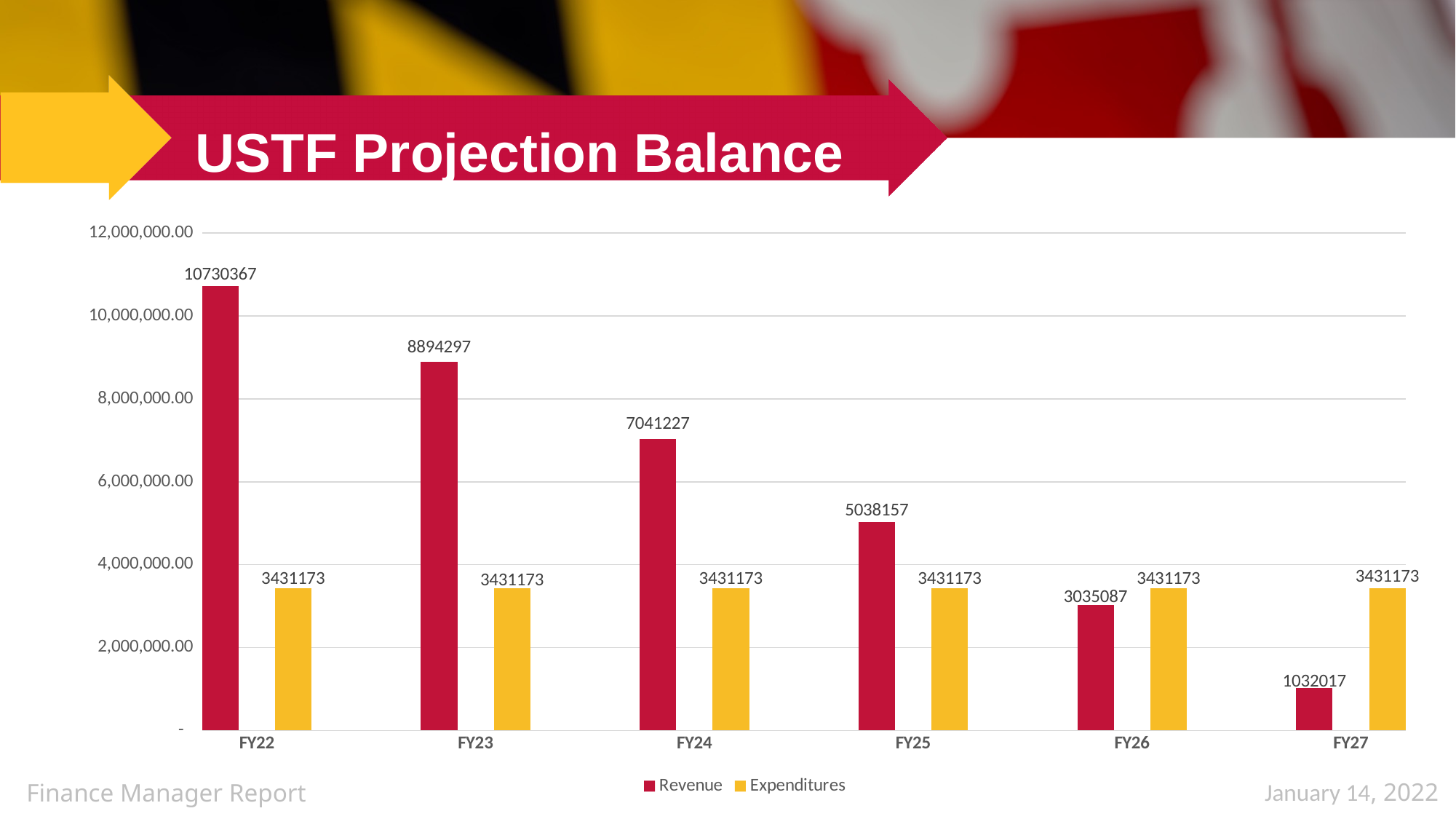
What is the difference between Revenue and Expenditures in FY24? 3610054 Which fiscal year has the highest Revenue? FY22 Which fiscal year has the lowest Revenue? FY27 Does Revenue rise or fall from FY22 to FY27? Fall What is the Expenditures value for FY25? 3431173 How many fiscal years are shown on the x axis? 6 Is the Revenue value for FY23 greater or less than 8,000,000.00? greater In FY26, which is larger, Revenue or Expenditures? Expenditures What is the Revenue value for FY22? 10730367 How many series does the legend list? 2 What kind of chart is shown on the slide? Bar chart What is the Revenue value for FY27? 1032017